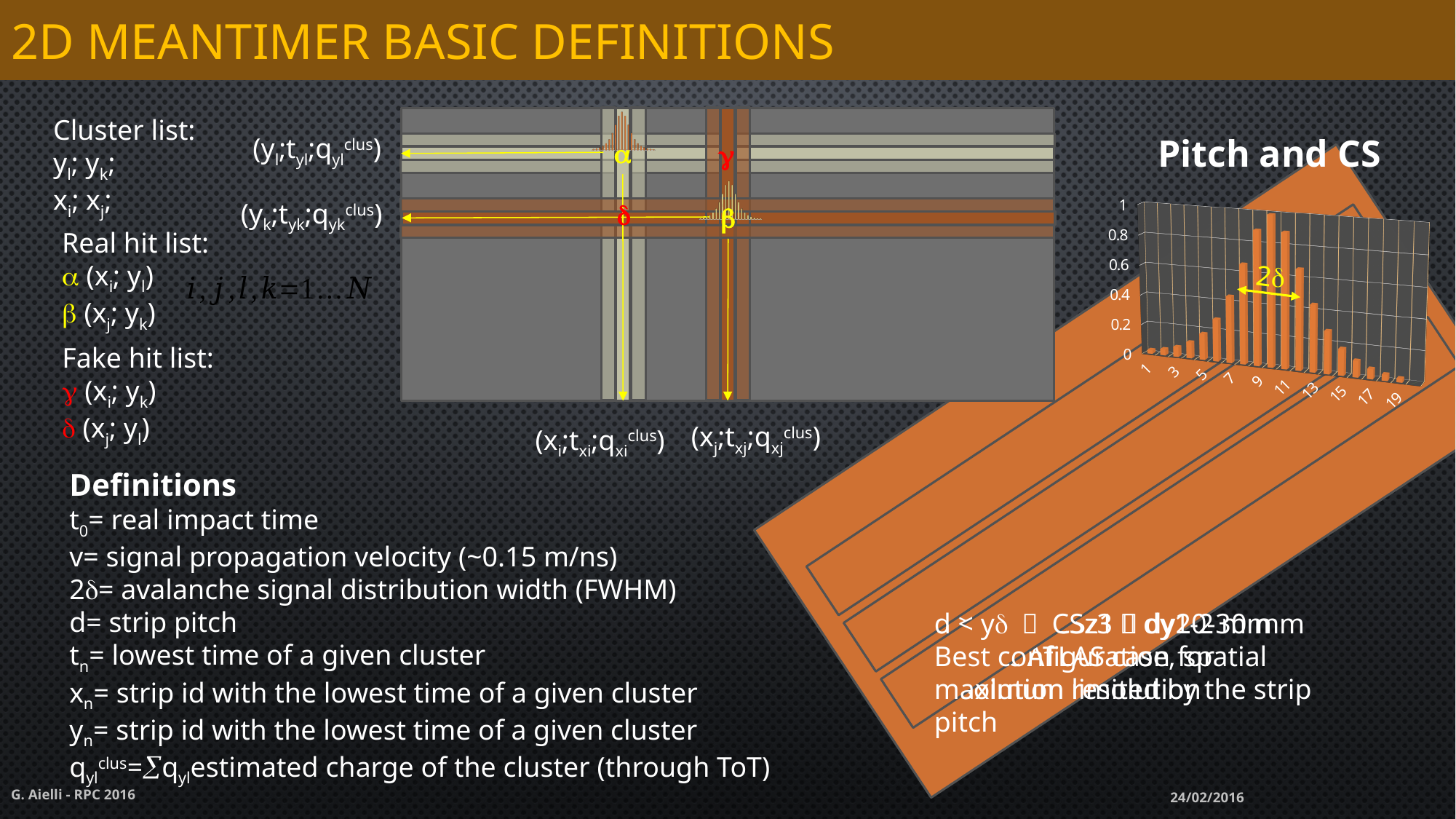
In the "Pitch and CS" chart, which is larger, the value for category 19 or the value for category 11? category 11 In the "Pitch and CS" chart, is the value for category 19 greater or less than 0.2? less In the "Pitch and CS" chart, do the values rise or fall from category 1 to category 9? rise What is the title of the chart on the right side of the slide? Pitch and CS In the "Pitch and CS" chart, is the value for category 1 greater or less than 0.2? less In the "Pitch and CS" chart, is the value for category 9 greater or less than 0.4? greater What kind of chart is shown under the title "Pitch and CS"? bar chart In the "Pitch and CS" chart, do the values rise or fall from category 11 to category 19? fall In the "Pitch and CS" chart, which is larger, the value for category 1 or the value for category 9? category 9 In the "Pitch and CS" chart, what label is written with the double-headed arrow across the peak of the distribution? 2δ In the "Pitch and CS" chart, what is the highest value shown on the vertical axis? 1